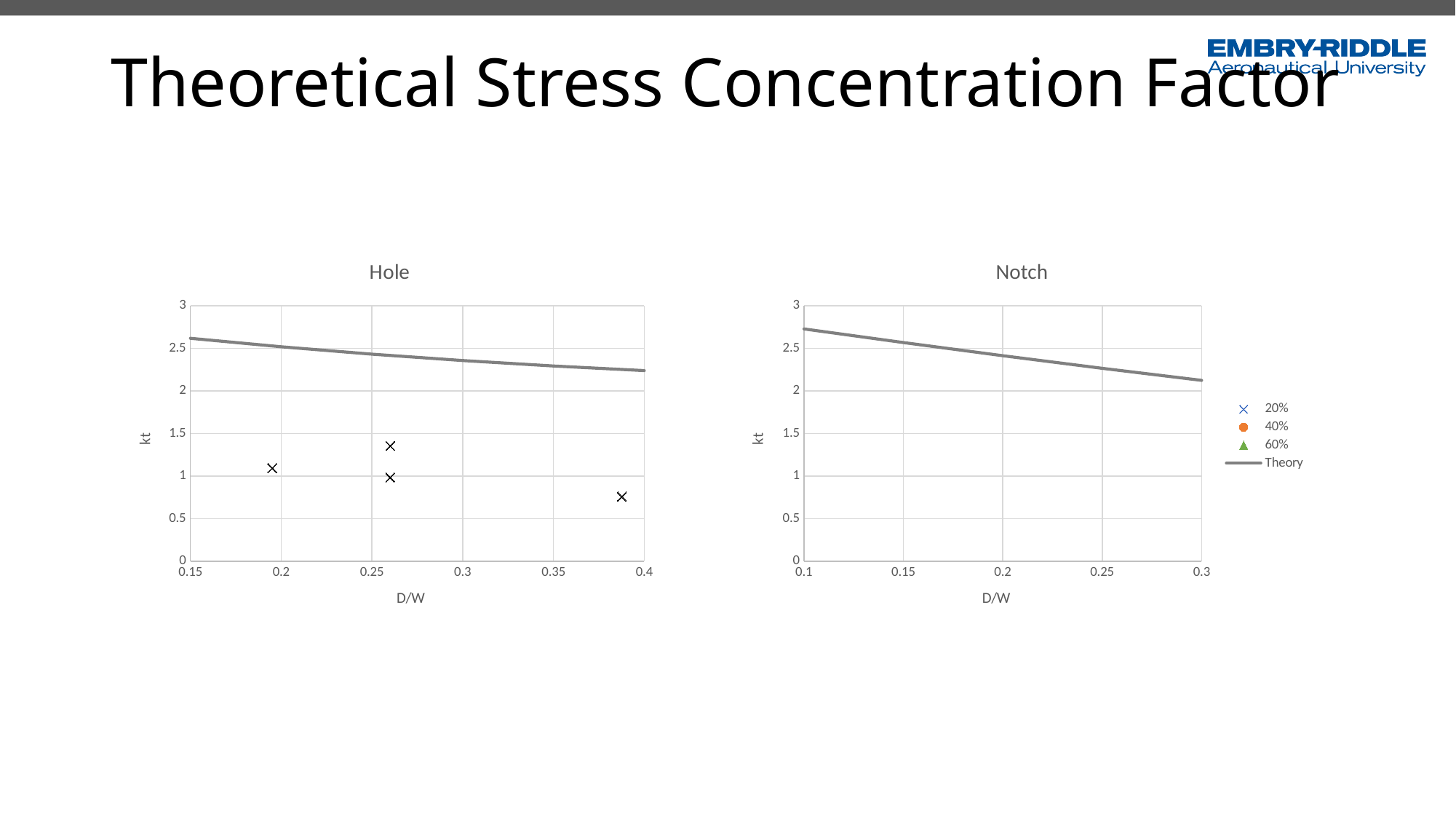
In the Hole chart, are the 20% data points above or below the Theory line? below What is the label on the x axis of both charts? D/W How many series does the legend list? 4 In the Notch chart, does the Theory line rise or fall as D/W increases? fall In the Hole chart, is the Theory value at D/W = 0.4 greater or less than 2.5? less In the Notch chart, is the Theory value at D/W = 0.1 greater or less than 2.5? greater What kind of chart is the Hole chart? scatter chart In the Hole chart, is the Theory value at D/W = 0.15 greater or less than 2.5? greater In the Hole chart, does the Theory line rise or fall as D/W increases? fall